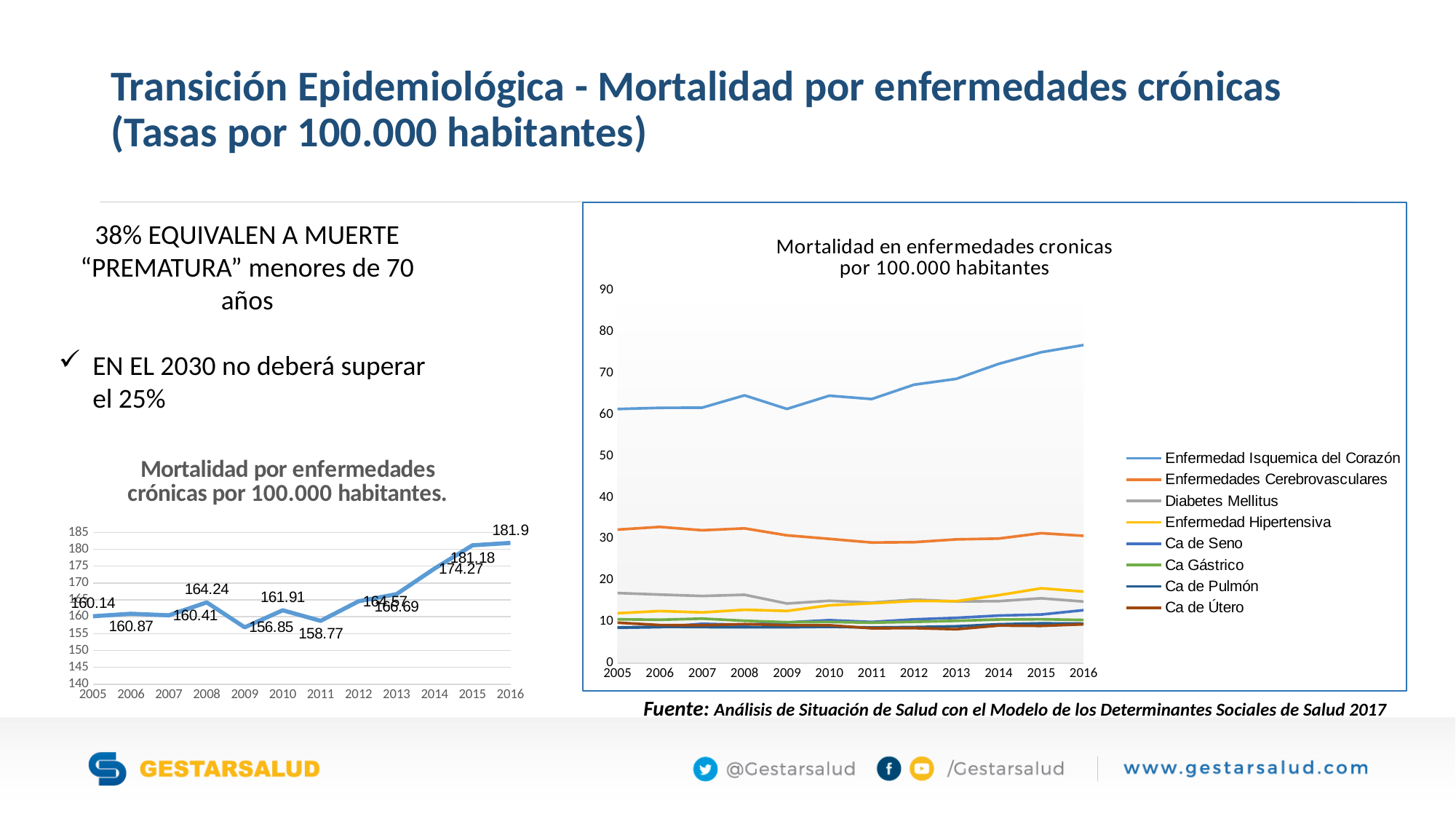
On the right chart 'Mortalidad en enfermedades cronicas por 100.000 habitantes', does the Enfermedad Isquemica del Corazón series rise or fall overall from 2005 to 2016? rise On the left chart 'Mortalidad por enfermedades crónicas por 100.000 habitantes.', which year has the highest value? 2016 On the right chart 'Mortalidad en enfermedades cronicas por 100.000 habitantes', is the value for Enfermedad Isquemica del Corazón in 2016 greater or less than 70? greater On the left chart 'Mortalidad por enfermedades crónicas por 100.000 habitantes.', what is the value for 2014? 174.27 On the left chart 'Mortalidad por enfermedades crónicas por 100.000 habitantes.', how many years are plotted? 12 On the left chart 'Mortalidad por enfermedades crónicas por 100.000 habitantes.', which year has the lowest value? 2009 On the left chart 'Mortalidad por enfermedades crónicas por 100.000 habitantes.', what is the value for 2009? 156.85 On the left chart 'Mortalidad por enfermedades crónicas por 100.000 habitantes.', what is the value for 2016? 181.9 What kind of chart is the right chart 'Mortalidad en enfermedades cronicas por 100.000 habitantes'? line chart On the left chart 'Mortalidad por enfermedades crónicas por 100.000 habitantes.', what is the difference between the 2015 value and the 2014 value? 6.91 On the right chart 'Mortalidad en enfermedades cronicas por 100.000 habitantes', how many series does the legend list? 8 On the left chart 'Mortalidad por enfermedades crónicas por 100.000 habitantes.', which is larger, the value for 2008 or the value for 2011? 2008